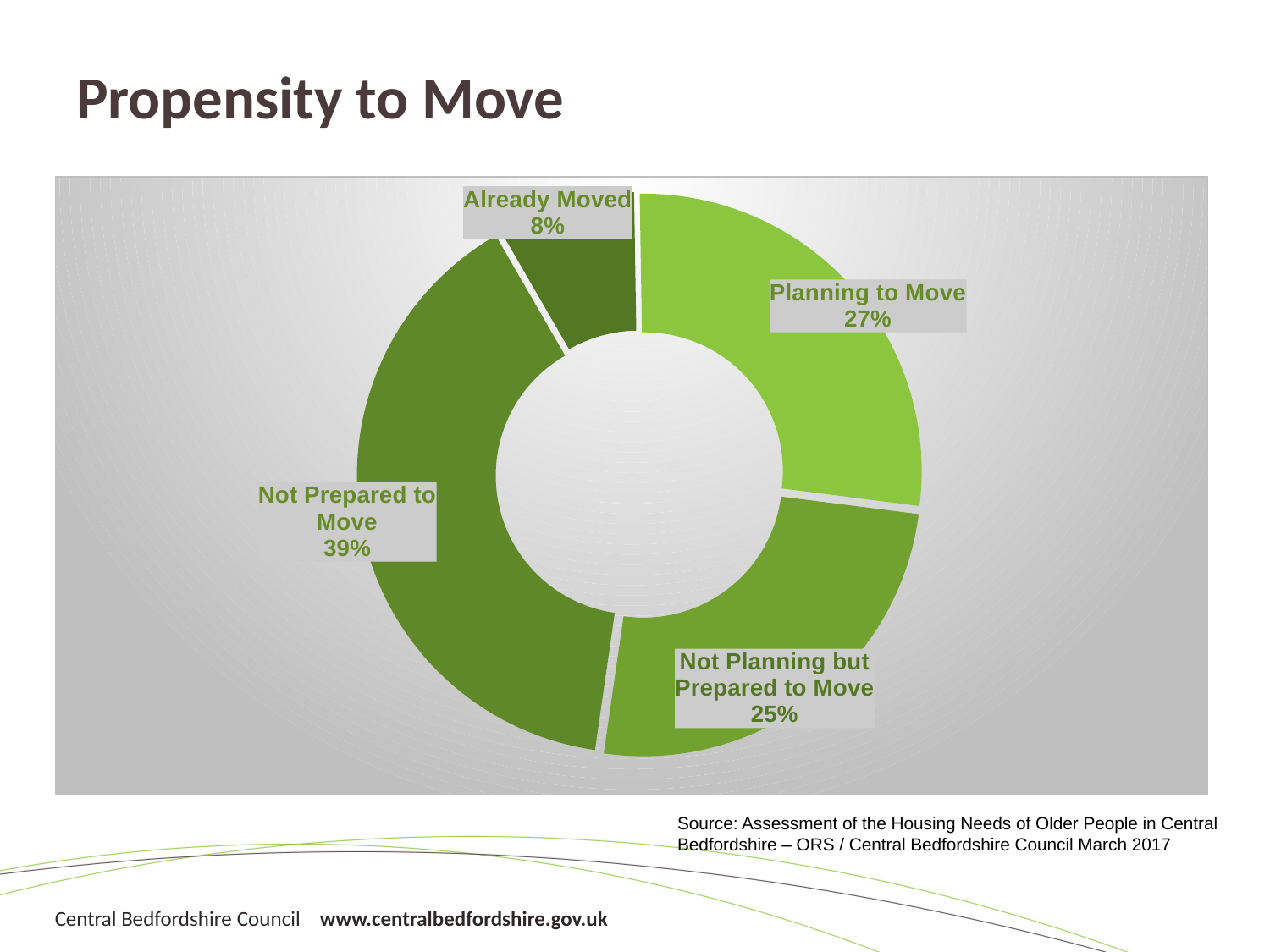
How many categories are shown in the chart? 4 What is the difference in percentage points between Not Prepared to Move and Planning to Move? 12 Which is larger: Planning to Move or Not Planning but Prepared to Move? Planning to Move What percentage of respondents are Not Prepared to Move? 39% What is the title of the slide containing the chart? Propensity to Move Which category has the smallest share of the chart? Already Moved What percentage of respondents are Not Planning but Prepared to Move? 25% What percentage of respondents have Already Moved? 8% Which category has the largest share of the chart? Not Prepared to Move What is the combined share of Planning to Move and Not Planning but Prepared to Move? 52% What percentage of respondents are Planning to Move? 27% What kind of chart is shown on the slide? Doughnut (pie) chart